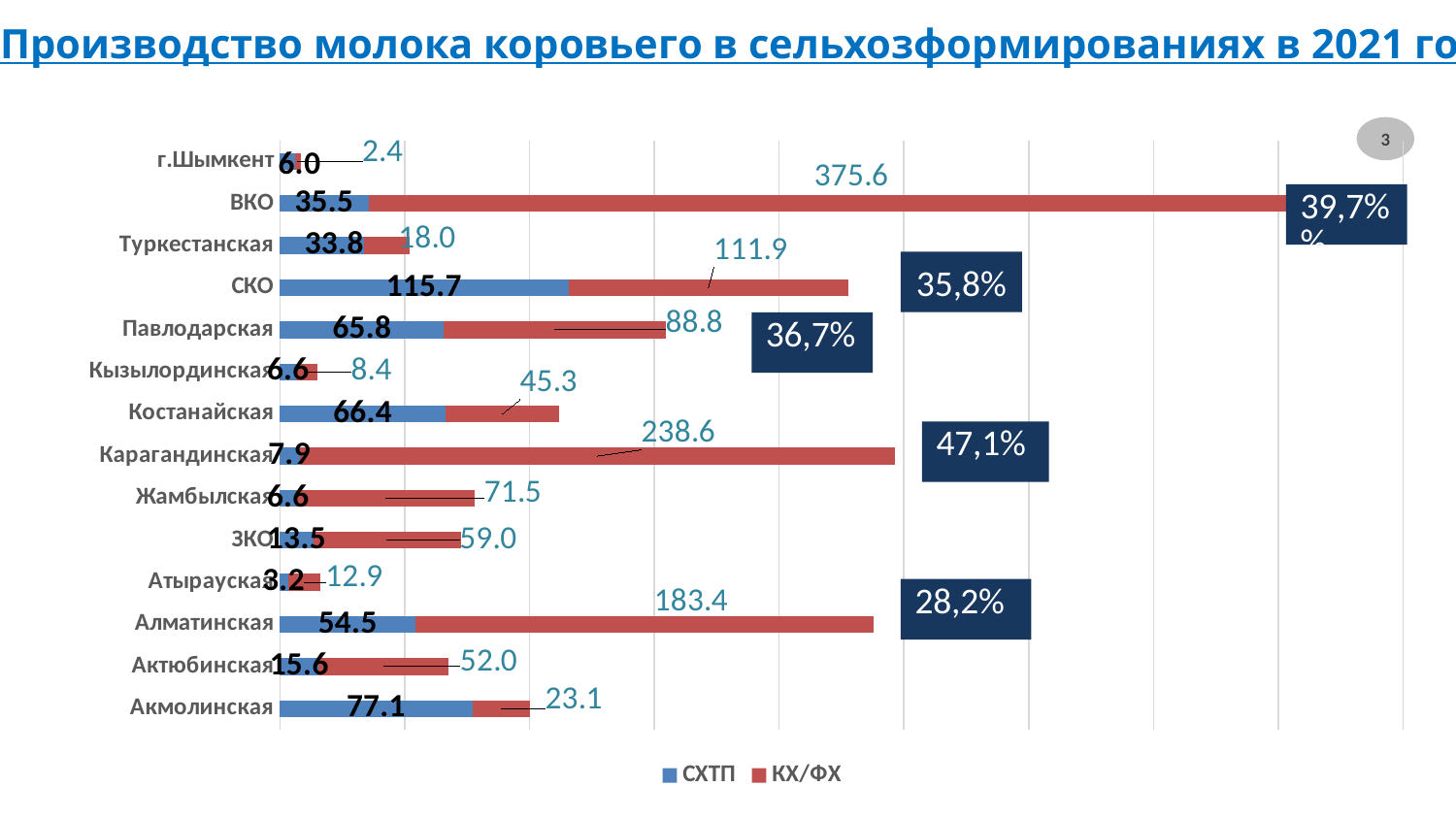
What is the difference between the КХ/ФХ and СХТП values for ВКО? 340.1 Which series is shown in red in the legend? КХ/ФХ How many regions (categories) are plotted in the chart? 14 What is the КХ/ФХ value for Карагандинская? 238.6 How many series does the legend list? 2 What is the СХТП value for СКО? 115.7 Which region has the highest КХ/ФХ value? ВКО What is the total of the stacked bar for СКО (СХТП plus КХ/ФХ)? 227.6 What is the КХ/ФХ value for ВКО? 375.6 Which region has the lowest СХТП value? Атырауская Which is larger for Акмолинская: the СХТП value or the КХ/ФХ value? СХТП What type of chart is shown on the slide? bar chart